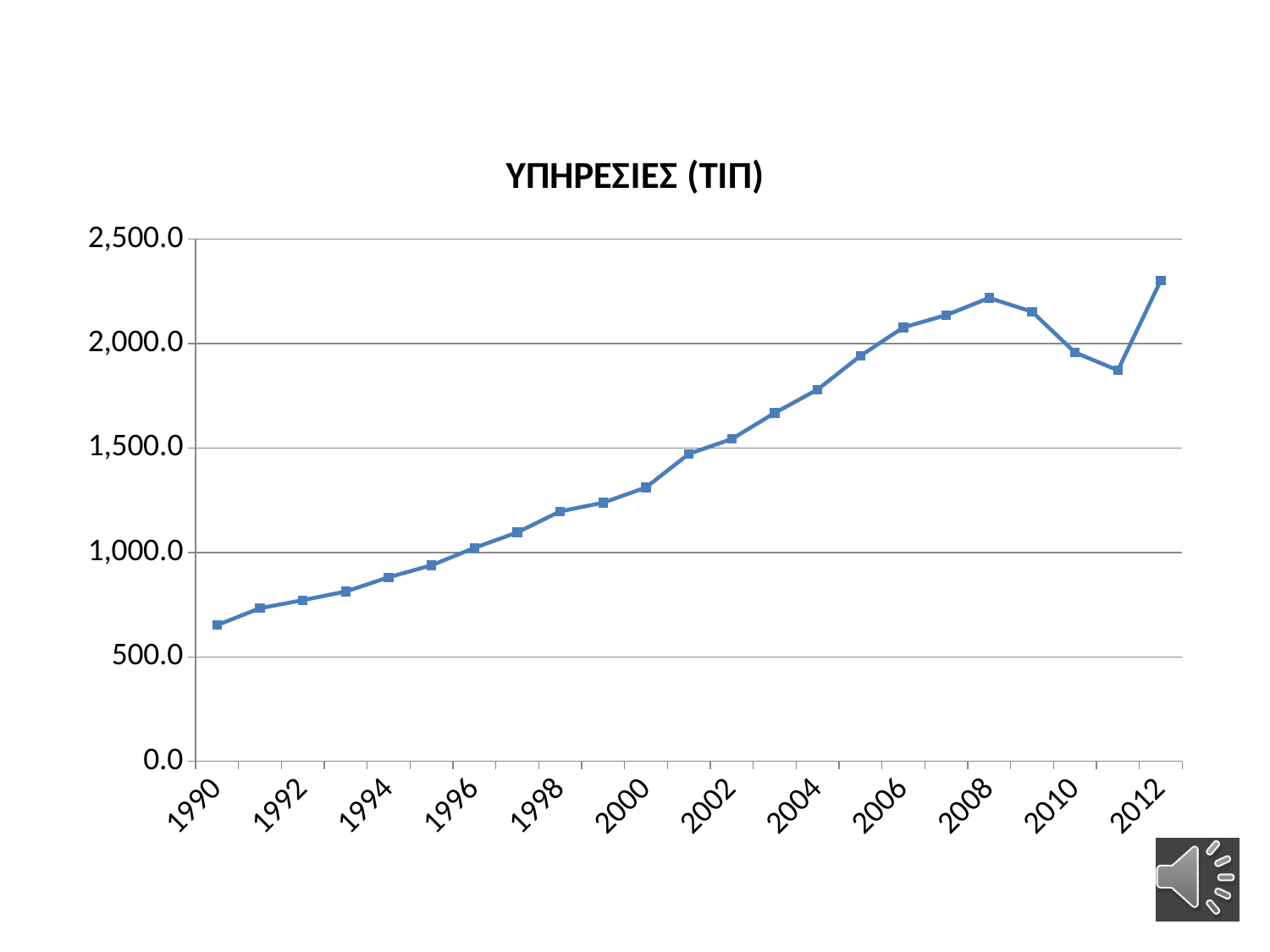
Which year has the lowest value? 1990 Is the value for 2008 greater or less than 2,000? greater Is the value for 2000 greater or less than 1,500? less How many data points are plotted on the line? 23 Is the value for 2004 greater or less than 1,500? greater Which year has the highest value? 2012 Which year has the larger value, 2008 or 2010? 2008 What is the title of the chart? ΥΠΗΡΕΣΙΕΣ (ΤΙΠ) What kind of chart is shown on the slide? line chart Do the values generally rise or fall from 1990 to 2008? rise